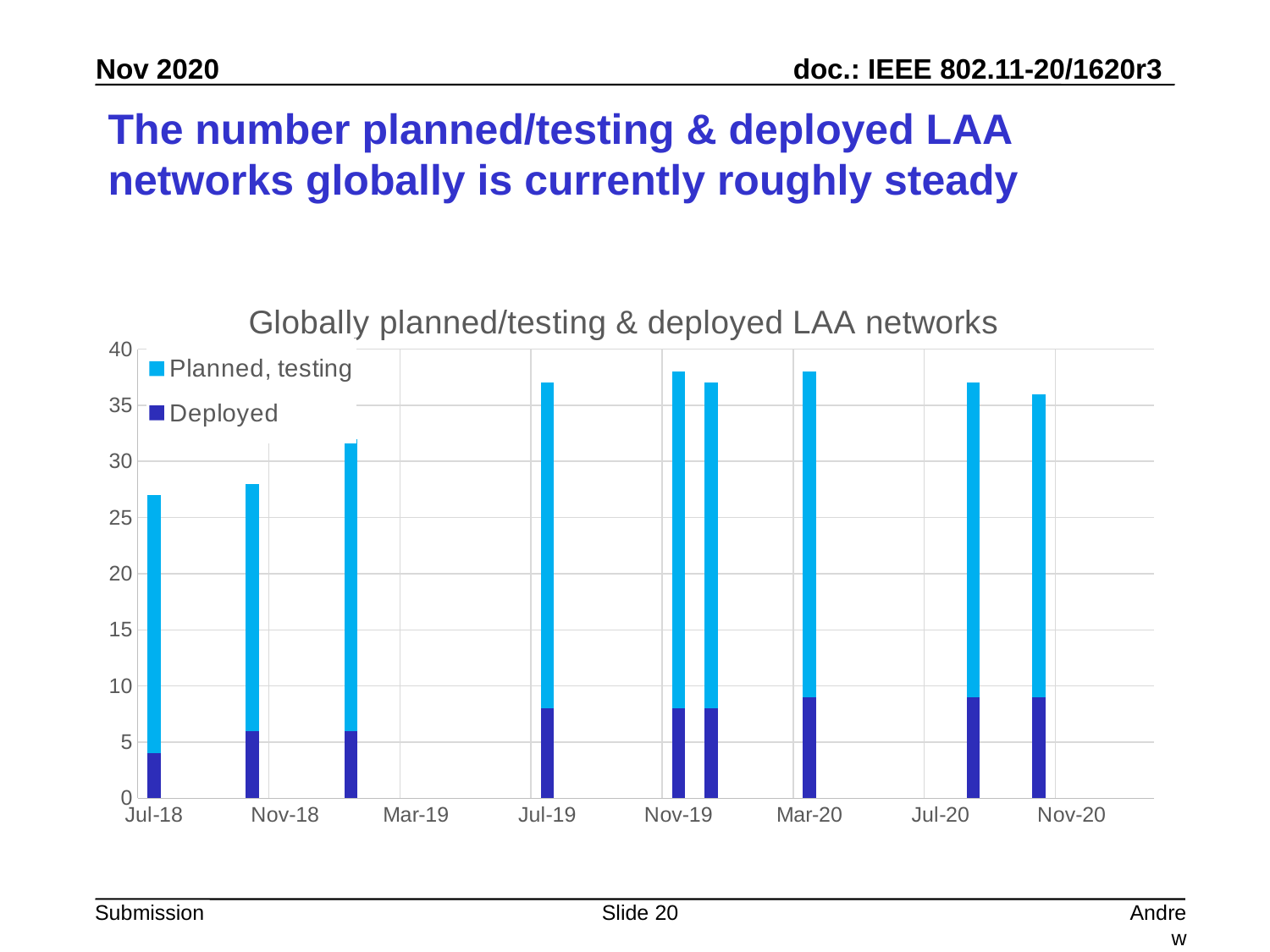
Which date has the lowest total number of networks in the chart? Jul-18 Is the total height of the Jul-19 bar greater or less than 35? greater Is the total height of the Jul-18 bar greater or less than 30? less What is the title of the chart? Globally planned/testing & deployed LAA networks How many series does the chart legend list? 2 Do the total bar heights generally rise or fall from Jul-18 to Jul-19? rise What kind of chart is shown on the slide? Stacked bar chart Is the Deployed value for Mar-20 greater or less than 5? greater What are the two series named in the chart legend? Planned, testing; Deployed Which bar has the lowest total, Jul-18 or Jul-19? Jul-18 How many stacked bars are plotted in the chart? 9